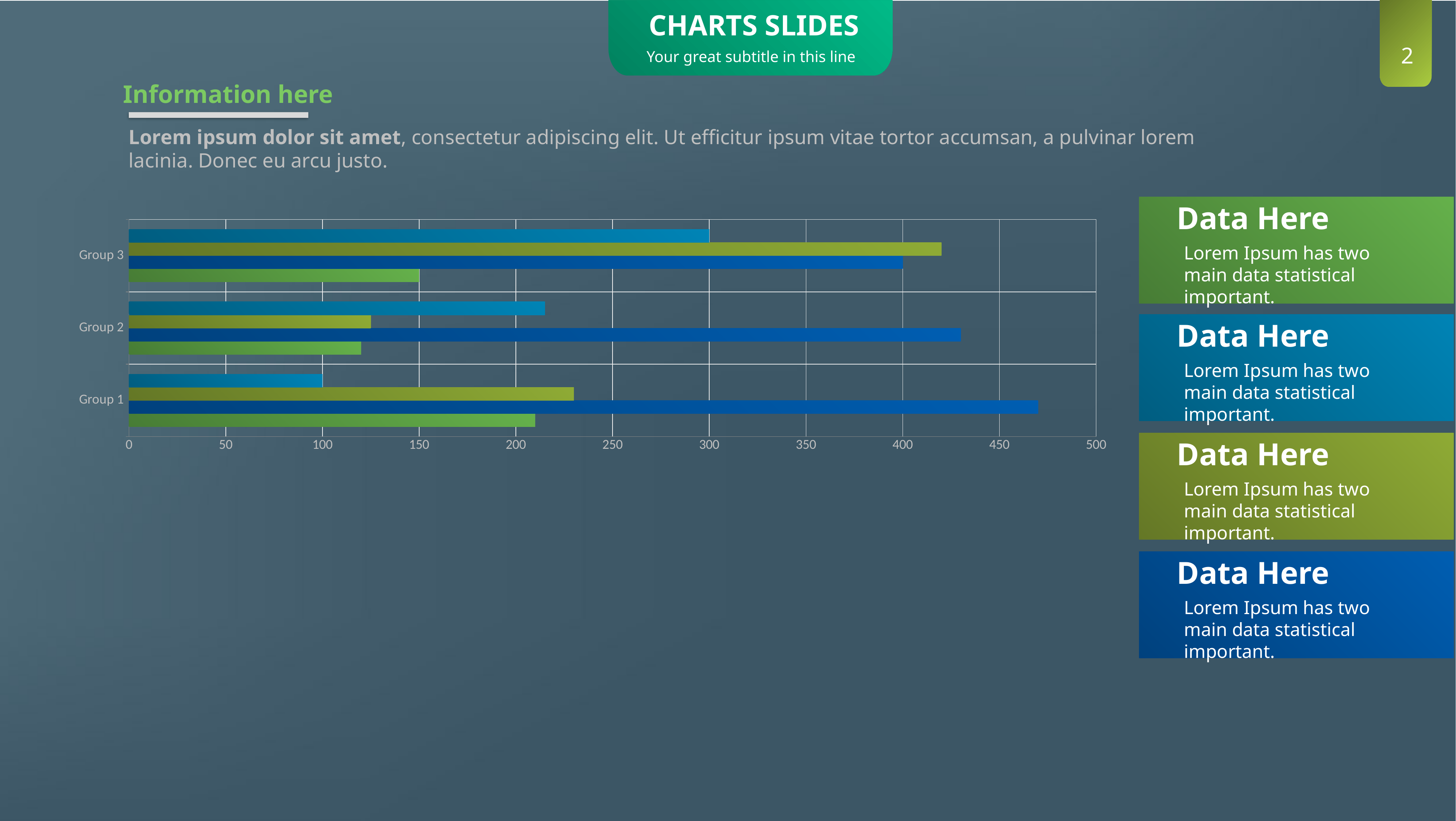
Which group has the longest bar in the chart? Group 1 How many groups (categories) are shown on the chart's vertical axis? 3 What kind of chart is shown on the slide? bar chart What is the value of the teal (top) bar for Group 3? 300 What is the value of the green (bottom) bar for Group 3? 150 Is the value of the olive green (second) bar for Group 2 greater or less than 150? less What is the value of the teal (top) bar for Group 1? 100 How many bars are plotted for each group in the chart? 4 Is the value of the teal (top) bar for Group 2 greater or less than 200? greater For Group 3, which bar is longer: the olive green (second) bar or the teal (top) bar? the olive green bar Is the value of the dark blue (third) bar for Group 1 greater or less than 450? greater What is the value of the dark blue (third) bar for Group 3? 400